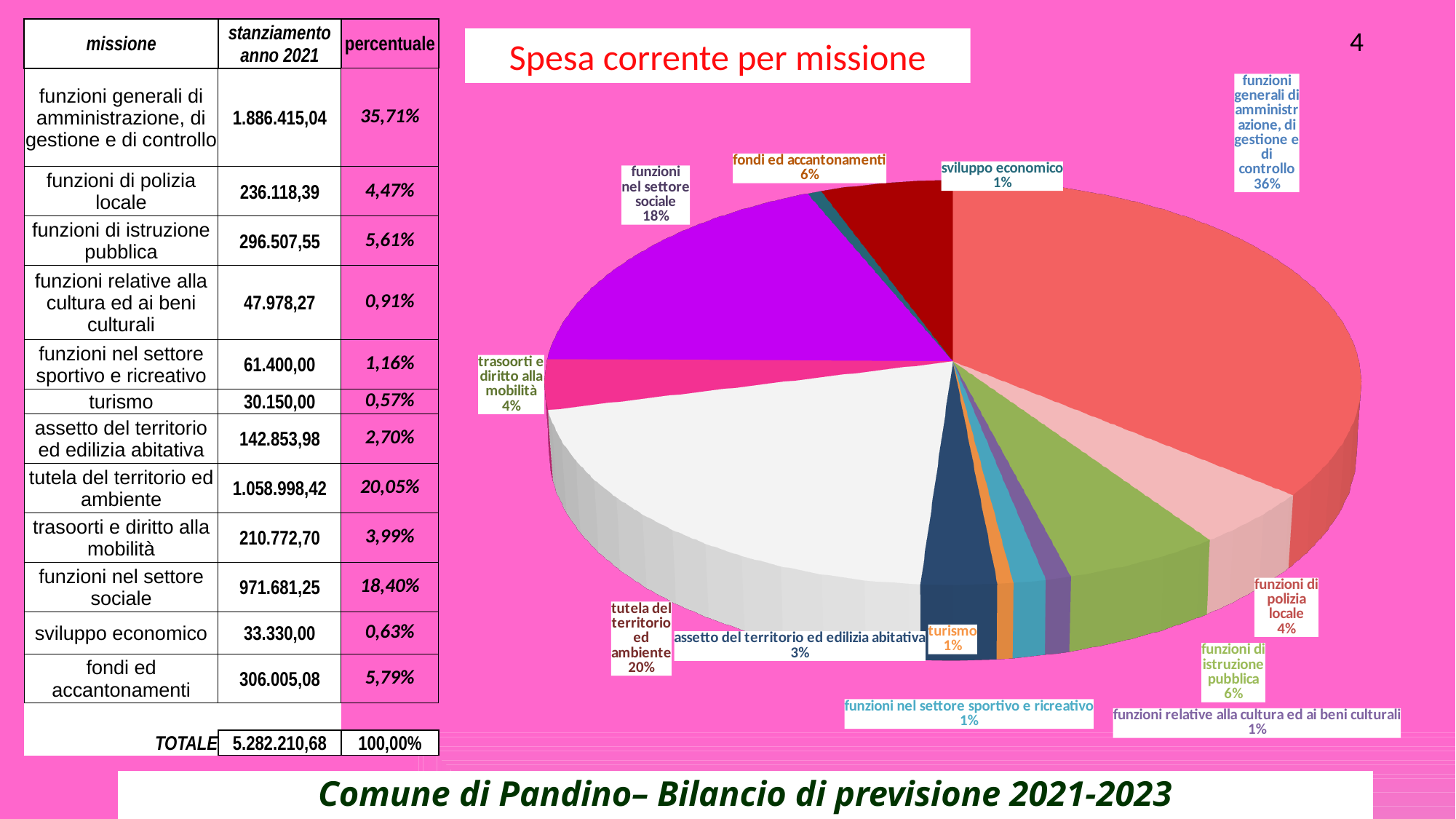
What kind of chart is shown on the slide? pie chart What is the difference in percentage points between 'funzioni generali di amministrazione, di gestione e di controllo' and 'tutela del territorio ed ambiente'? 16 What percentage is shown for 'trasoorti e diritto alla mobilità'? 4% Which mission has the largest slice of the pie? funzioni generali di amministrazione, di gestione e di controllo What percentage is shown for 'tutela del territorio ed ambiente'? 20% What share of the pie does 'funzioni generali di amministrazione, di gestione e di controllo' represent? 36% What percentage is shown for 'funzioni nel settore sociale'? 18% What is the title of the chart? Spesa corrente per missione Which is larger: the slice for 'tutela del territorio ed ambiente' or the slice for 'funzioni nel settore sociale'? tutela del territorio ed ambiente What percentage is shown for 'fondi ed accantonamenti'? 6% How many slices does the pie chart have? 12 What percentage is shown for 'assetto del territorio ed edilizia abitativa'? 3%